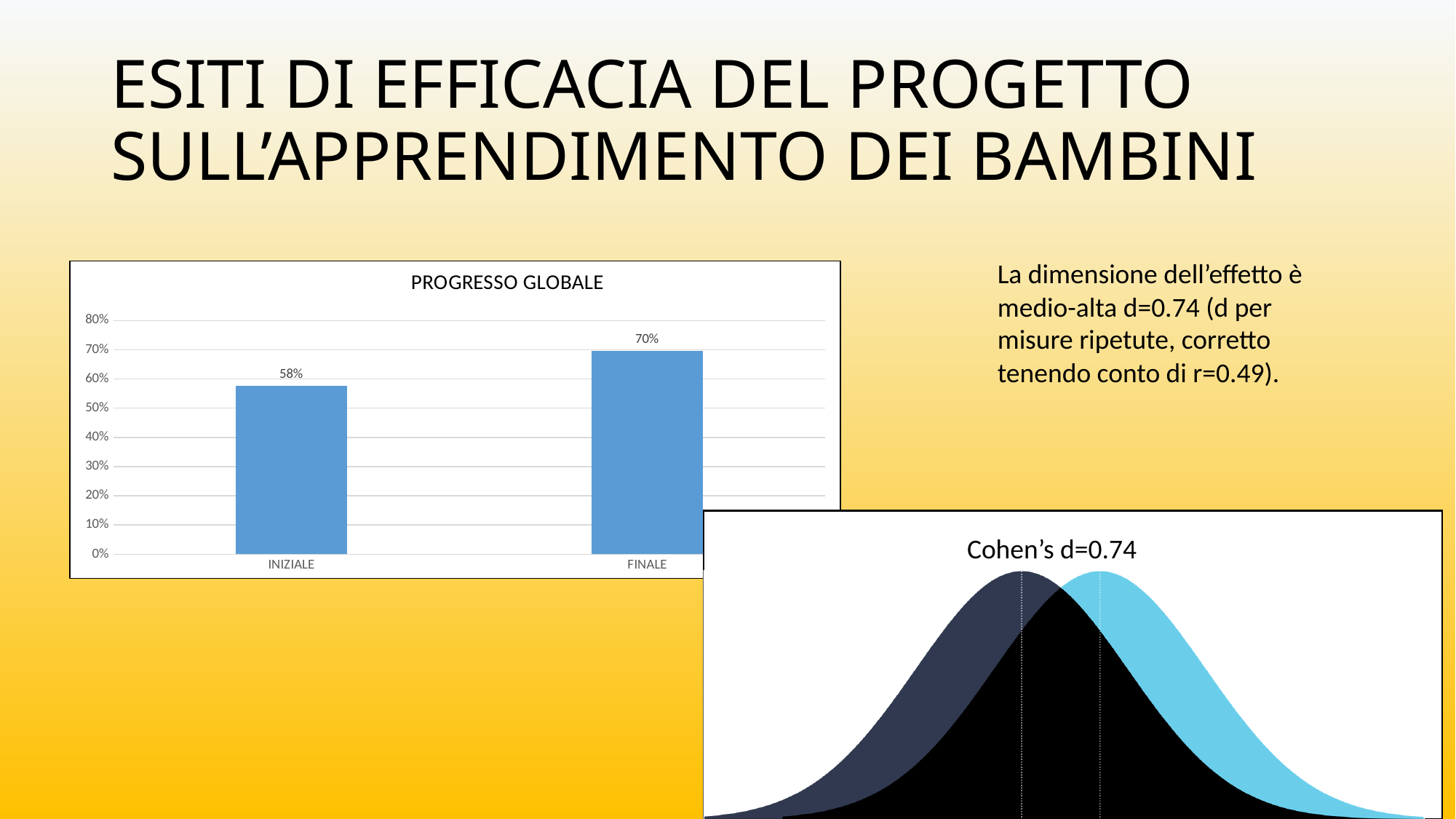
In the PROGRESSO GLOBALE chart, what is the value for FINALE? 70% What kind of chart is the PROGRESSO GLOBALE chart? bar chart What is the title of the chart in the bottom right of the slide? Cohen's d=0.74 In the PROGRESSO GLOBALE chart, which category has the highest value? FINALE In the PROGRESSO GLOBALE chart, what is the value for INIZIALE? 58% In the PROGRESSO GLOBALE chart, do the values rise or fall from INIZIALE to FINALE? rise In the PROGRESSO GLOBALE chart, which category has the lowest value? INIZIALE In the PROGRESSO GLOBALE chart, is the value for FINALE greater or less than 60%? greater How many categories are shown in the PROGRESSO GLOBALE chart? 2 In the PROGRESSO GLOBALE chart, which is larger, INIZIALE or FINALE? FINALE In the PROGRESSO GLOBALE chart, is the value for INIZIALE greater or less than 60%? less In the PROGRESSO GLOBALE chart, what is the difference between the FINALE and INIZIALE values? 12%